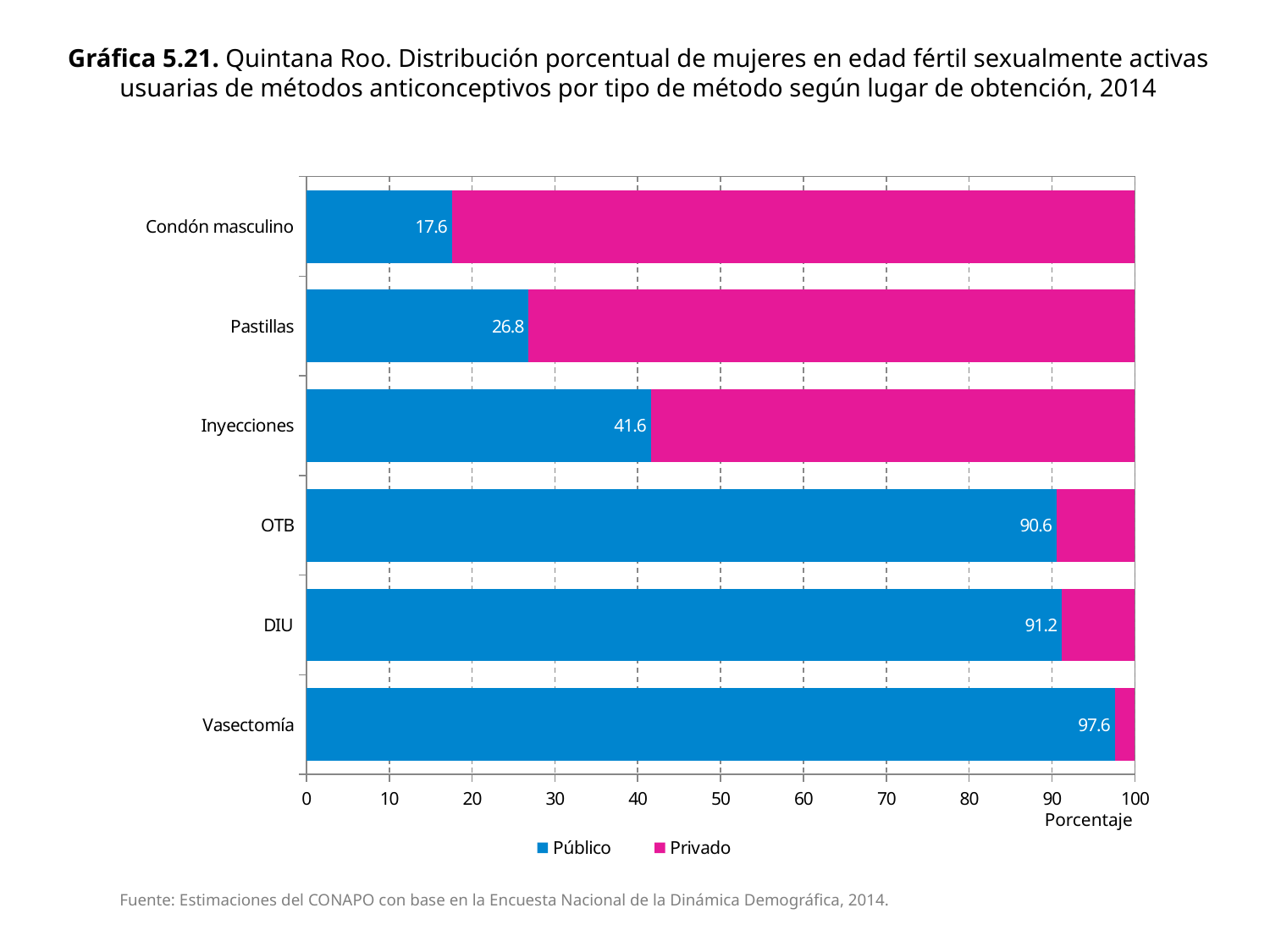
What is the Público value for Inyecciones? 41.6 Is the Privado value for OTB greater or less than 10? less What is the Público value for DIU? 91.2 Which method has the highest Público value? Vasectomía What is the Público value for Condón masculino? 17.6 Which has a larger Público value, OTB or Inyecciones? OTB How many series does the legend list? 2 What kind of chart is shown? Stacked bar chart Which method has the lowest Público value? Condón masculino Is the Privado value for Condón masculino greater or less than 80? greater What is the difference between the Público values for Pastillas and Condón masculino? 9.2 How many methods are shown on the chart? 6